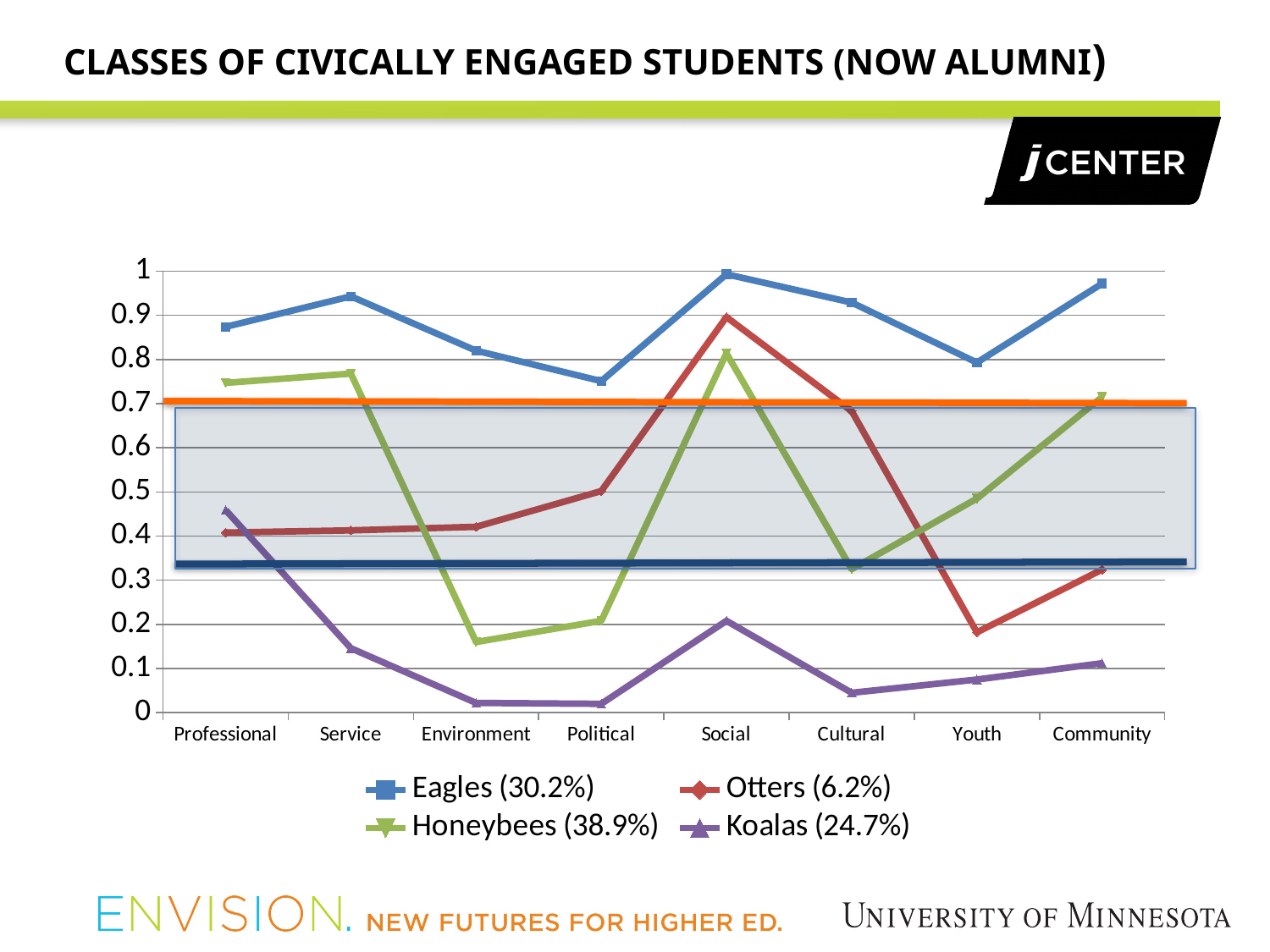
How many categories are shown along the x axis? 8 Is the value for Eagles at Social greater or less than 0.9? greater Is the value for Otters at Youth greater or less than 0.3? less At Cultural, which series has the larger value, Otters or Honeybees? Otters How many series does the legend list? 4 Which category has the lowest value for the Otters series? Youth Does the Koalas series rise or fall from Professional to Environment? Fall Which category has the highest value for the Koalas series? Professional What kind of chart is shown on the slide? Line chart What percentage is shown next to Honeybees in the legend? 38.9% Is the value for Koalas at Environment greater or less than 0.1? less Which category has the lowest value for the Honeybees series? Environment